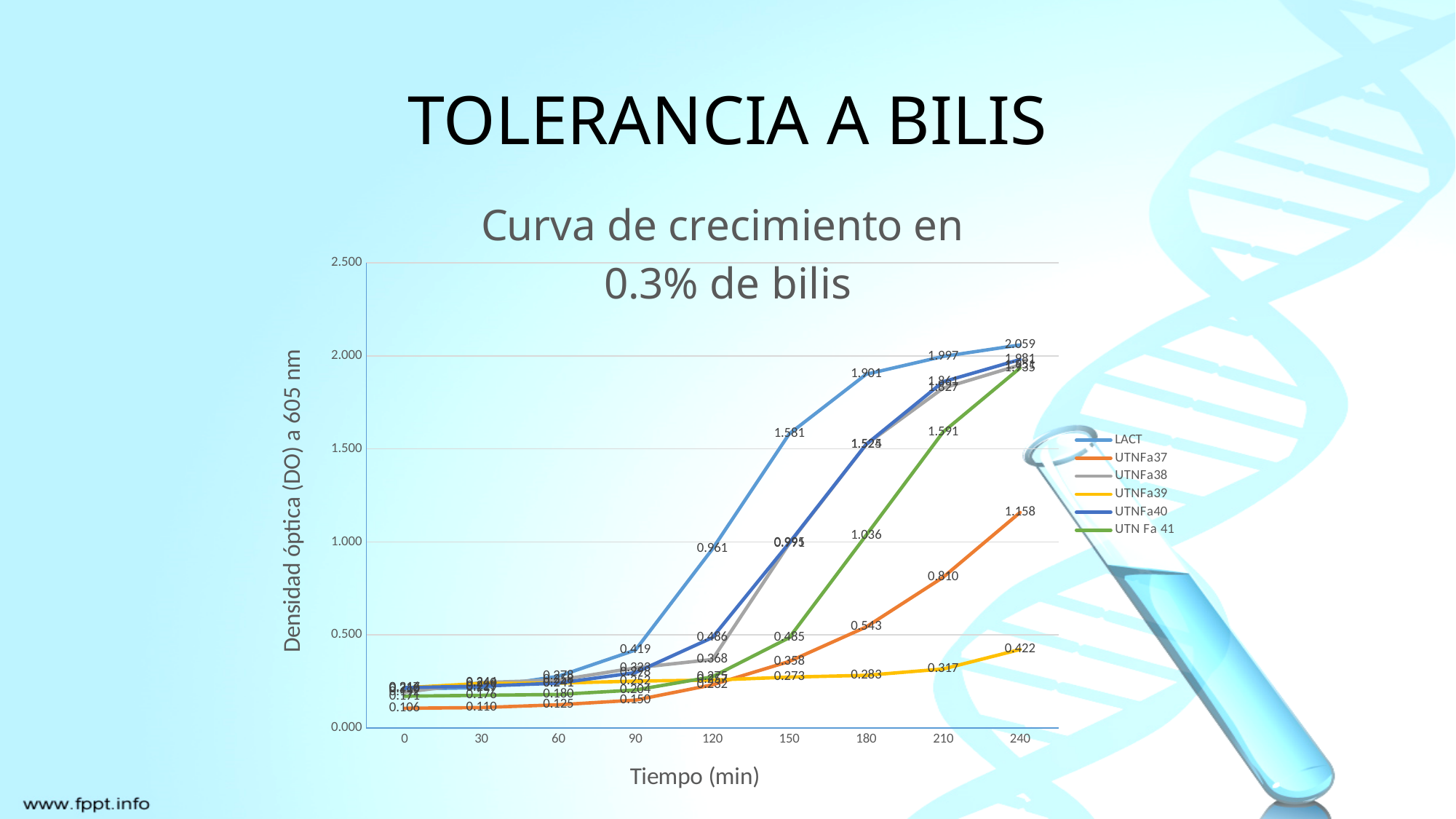
What is the value for LACT at 240 min? 2.059 What is the value for UTNFa37 at 0 min? 0.106 Does the LACT series rise or fall as time increases from 0 to 240 min? Rise What is the difference between the LACT and UTNFa37 values at 240 min? 0.901 Which series has the highest value at 240 min? LACT What kind of chart is shown on the slide? Line chart Which series has the lowest value at 240 min? UTNFa39 At 180 min, which is larger: LACT or UTN Fa 41? LACT How many series does the legend list? 6 What is the value for UTNFa37 at 240 min? 1.158 How many time points are plotted along the x axis? 9 What is the value for UTNFa39 at 240 min? 0.422